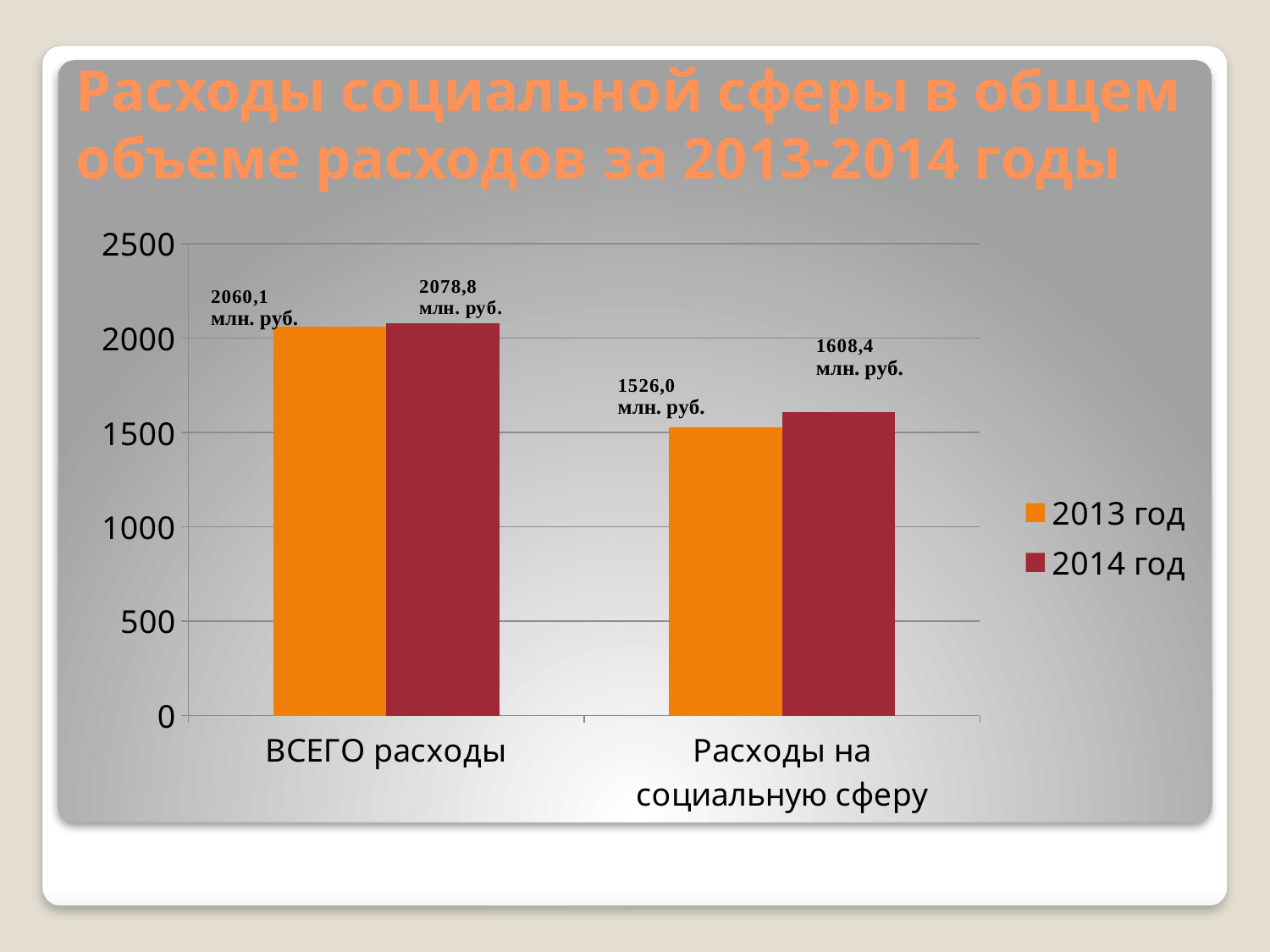
Which category has the lowest value for 2013 год? Расходы на социальную сферу What is the value for 2014 год in the ВСЕГО расходы category? 2078,8 млн. руб. What is the value for 2013 год in the ВСЕГО расходы category? 2060,1 млн. руб. What kind of chart is shown on the slide? Bar chart Which category has the highest value for 2014 год? ВСЕГО расходы Which is larger: the 2013 год value for ВСЕГО расходы or the 2014 год value for Расходы на социальную сферу? 2013 год value for ВСЕГО расходы What is the value for 2014 год in the Расходы на социальную сферу category? 1608,4 млн. руб. What is the difference between the 2014 год and 2013 год values for ВСЕГО расходы? 18,7 млн. руб. How many series does the legend list? 2 How many categories are shown on the x axis? 2 What is the difference between the 2014 год and 2013 год values for Расходы на социальную сферу? 82,4 млн. руб. What is the value for 2013 год in the Расходы на социальную сферу category? 1526,0 млн. руб.